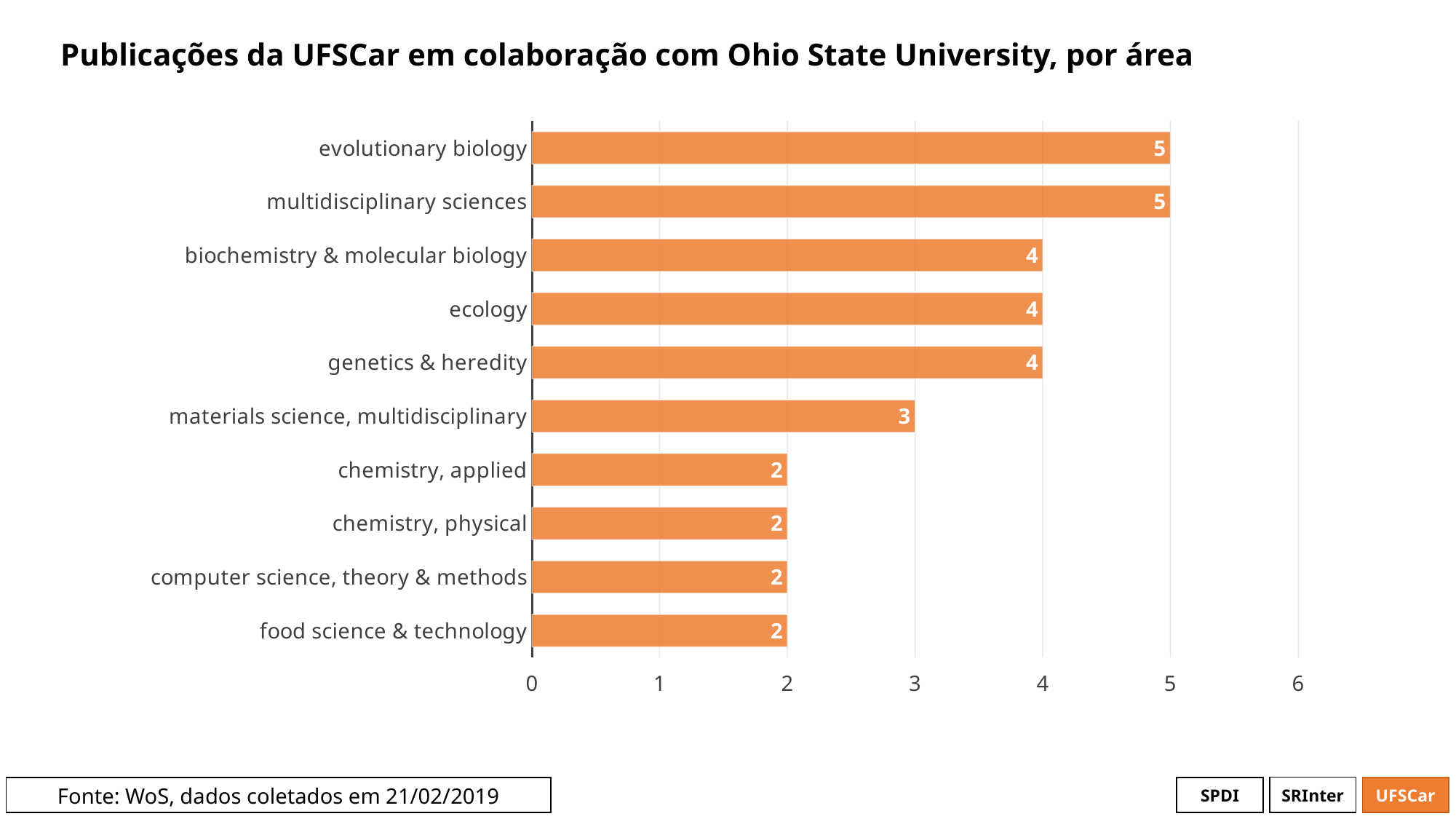
What is the value for ecology? 4 What colour are the bars in the chart? orange Which is larger, the value for genetics & heredity or the value for chemistry, applied? genetics & heredity What is the title of the chart? Publicações da UFSCar em colaboração com Ohio State University, por área What is the value for materials science, multidisciplinary? 3 What is the value for food science & technology? 2 What is the difference between the values for evolutionary biology and materials science, multidisciplinary? 2 What is the value for multidisciplinary sciences? 5 Which categories have the highest value? evolutionary biology and multidisciplinary sciences What kind of chart is shown on the slide? bar chart What is the lowest value shown in the chart? 2 How many categories are shown in the chart? 10